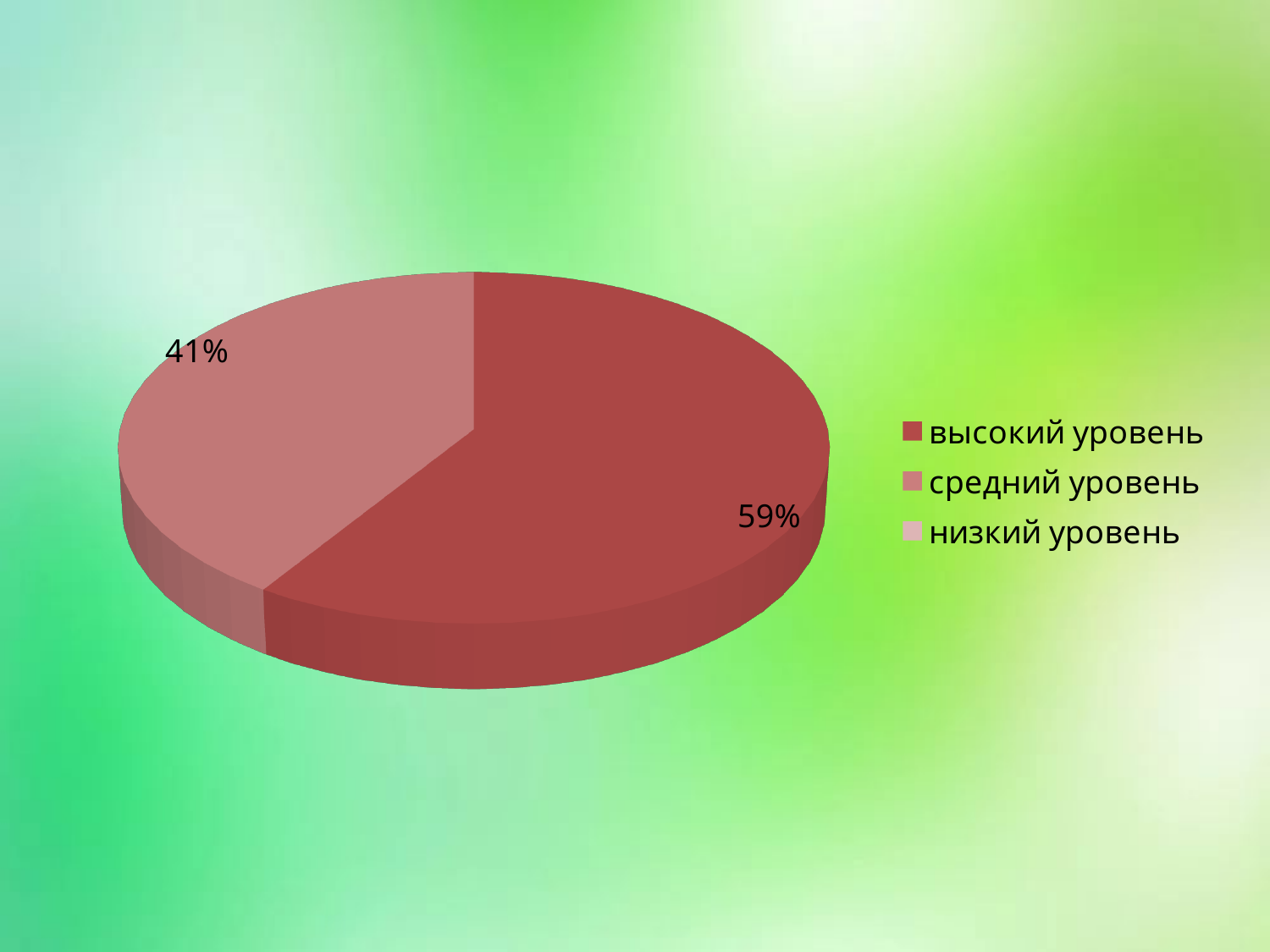
What kind of chart is shown on the slide? pie chart What colour is the slice for высокий уровень? dark red Which category has the largest slice of the pie? высокий уровень How many slices with data labels are visible in the pie? 2 Is the value for средний уровень greater or less than 50%? less What percentage is shown for высокий уровень? 59% Which legend entry has no visible slice in the pie? низкий уровень How many entries does the legend list? 3 What percentage is shown for средний уровень? 41% By how many percentage points does the высокий уровень slice exceed the средний уровень slice? 18 percentage points Which is larger, the slice for высокий уровень or the slice for средний уровень? высокий уровень Is the value for высокий уровень greater or less than 50%? greater